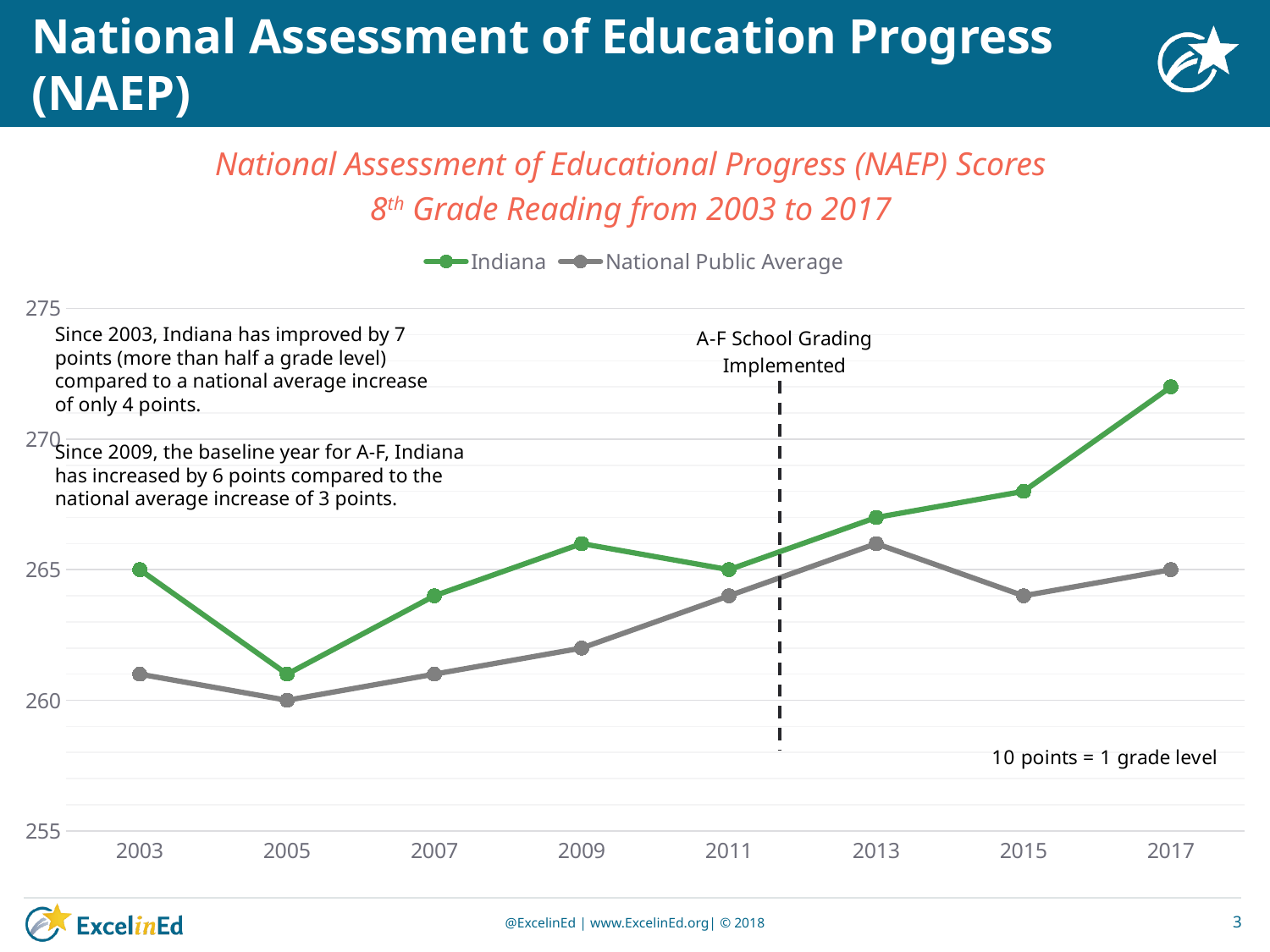
How many years are plotted along the x axis? 8 In which year is the National Public Average score lowest? 2005 Is the Indiana value for 2017 greater or less than 270? greater In 2015, which series has the higher score, Indiana or National Public Average? Indiana What event does the dashed vertical line on the chart mark? A-F School Grading Implemented What is the National Public Average score in 2005? 260 How many series does the legend list? 2 In which year is the Indiana score highest? 2017 Is the National Public Average value for 2003 greater or less than 265? less What is the National Public Average score in 2017? 265 What kind of chart is shown on the slide? line chart What is the Indiana score in 2003? 265